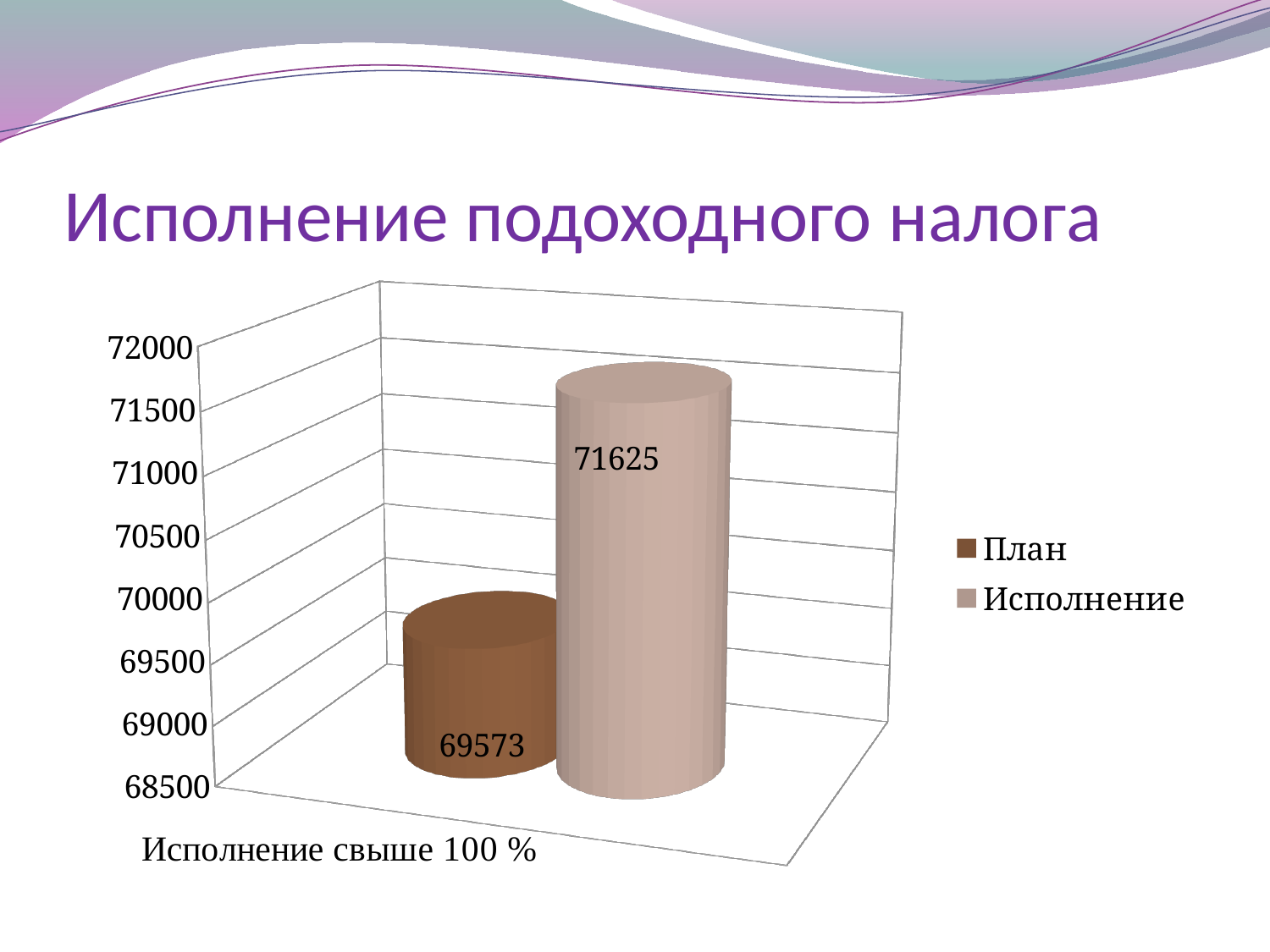
What is the value for План? 69573 What is the title of the slide? Исполнение подоходного налога What is the label shown below the chart? Исполнение свыше 100 % What is the difference between Исполнение and План? 2052 What is the value for Исполнение? 71625 Is the value for План greater or less than 70000? less Which series has the higher value, План or Исполнение? Исполнение How many series does the legend list? 2 What kind of chart is shown on the slide? bar chart Which series has the lowest value? План What is the highest value shown on the vertical axis? 72000 Is the value for Исполнение greater or less than 71000? greater